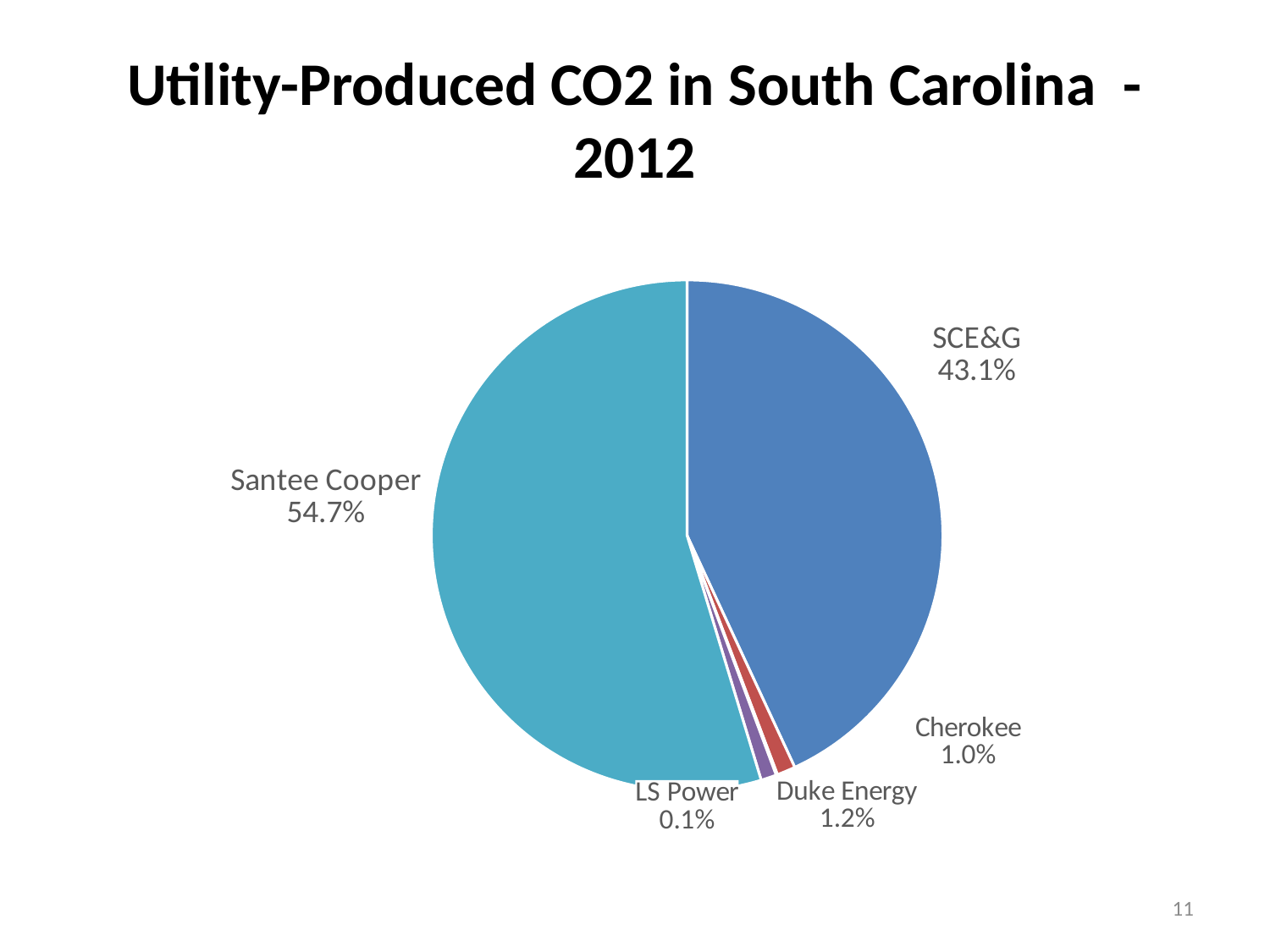
How many utilities are shown as slices in the pie chart? 5 What percentage is shown for LS Power? 0.1% What is the title of the chart on the slide? Utility-Produced CO2 in South Carolina - 2012 What percentage is shown for Duke Energy? 1.2% Which utility has the largest share of CO2 production in the chart? Santee Cooper What type of chart is shown on the slide? Pie chart Which has a larger share, Duke Energy or Cherokee? Duke Energy What share of utility-produced CO2 in South Carolina in 2012 is attributed to Santee Cooper? 54.7% What percentage is shown for Cherokee? 1.0% What share of the pie does SCE&G account for? 43.1% What is the difference in percentage points between Santee Cooper's share and SCE&G's share? 11.6 Which utility has the smallest share of CO2 production in the chart? LS Power